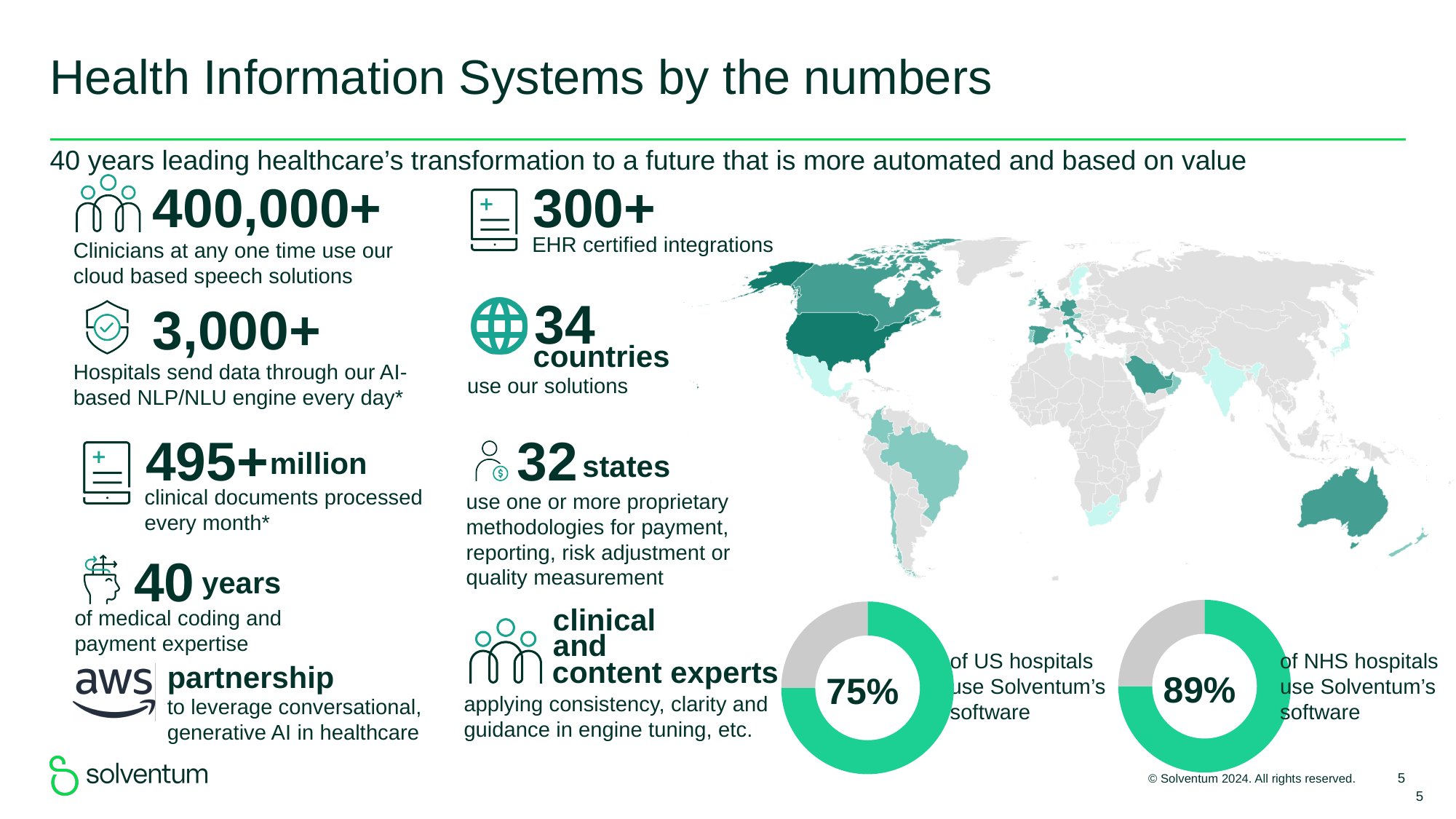
Which donut chart shows the lower percentage, the US hospitals chart or the NHS hospitals chart? US hospitals chart (75%) How many donut charts are shown on the slide? 2 What is the difference between the NHS hospitals share (89%) and the US hospitals share (75%) shown in the two donut charts? 14 percentage points In the right donut chart, what percentage of NHS hospitals use Solventum's software? 89% Which is larger: the share of US hospitals or the share of NHS hospitals using Solventum's software? NHS hospitals (89%) In the left donut chart, what share of the ring is filled in green? 75% What colour represents the hospitals that use Solventum's software in the donut charts? Green In the left donut chart, what percentage of US hospitals use Solventum's software? 75% What kind of chart is used to show the share of US hospitals using Solventum's software? Donut (pie) chart